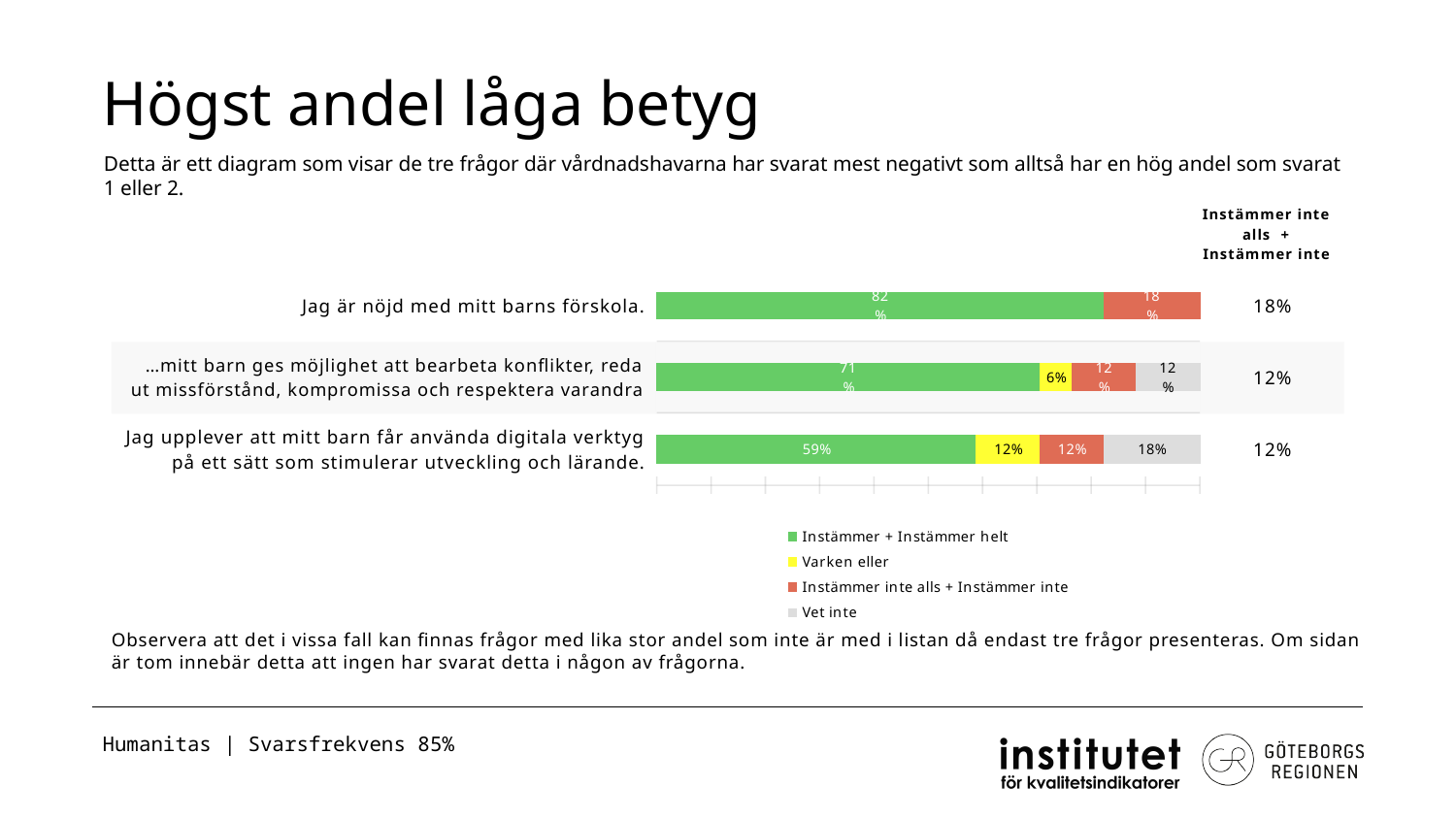
How many questions (categories) are plotted in the chart? 3 Which question has the lowest share of "Instämmer + Instämmer helt"? Jag upplever att mitt barn får använda digitala verktyg på ett sätt som stimulerar utveckling och lärande What kind of chart is shown on the slide? Stacked bar chart What is the value of "Varken eller" for "…mitt barn ges möjlighet att bearbeta konflikter, reda ut missförstånd, kompromissa och respektera varandra"? 6% What is the value of "Instämmer + Instämmer helt" for "Jag är nöjd med mitt barns förskola"? 82% What is the difference between the "Instämmer + Instämmer helt" share for "Jag är nöjd med mitt barns förskola" and for "Jag upplever att mitt barn får använda digitala verktyg på ett sätt som stimulerar utveckling och lärande"? 23% What is the value of "Instämmer + Instämmer helt" for "Jag upplever att mitt barn får använda digitala verktyg på ett sätt som stimulerar utveckling och lärande"? 59% What is the value of "Instämmer inte alls + Instämmer inte" for "Jag är nöjd med mitt barns förskola"? 18% How many series does the legend list? 4 Which question has the highest share of "Instämmer + Instämmer helt"? Jag är nöjd med mitt barns förskola Which series is shown in yellow in the legend? Varken eller What is the value of "Vet inte" for "Jag upplever att mitt barn får använda digitala verktyg på ett sätt som stimulerar utveckling och lärande"? 18%